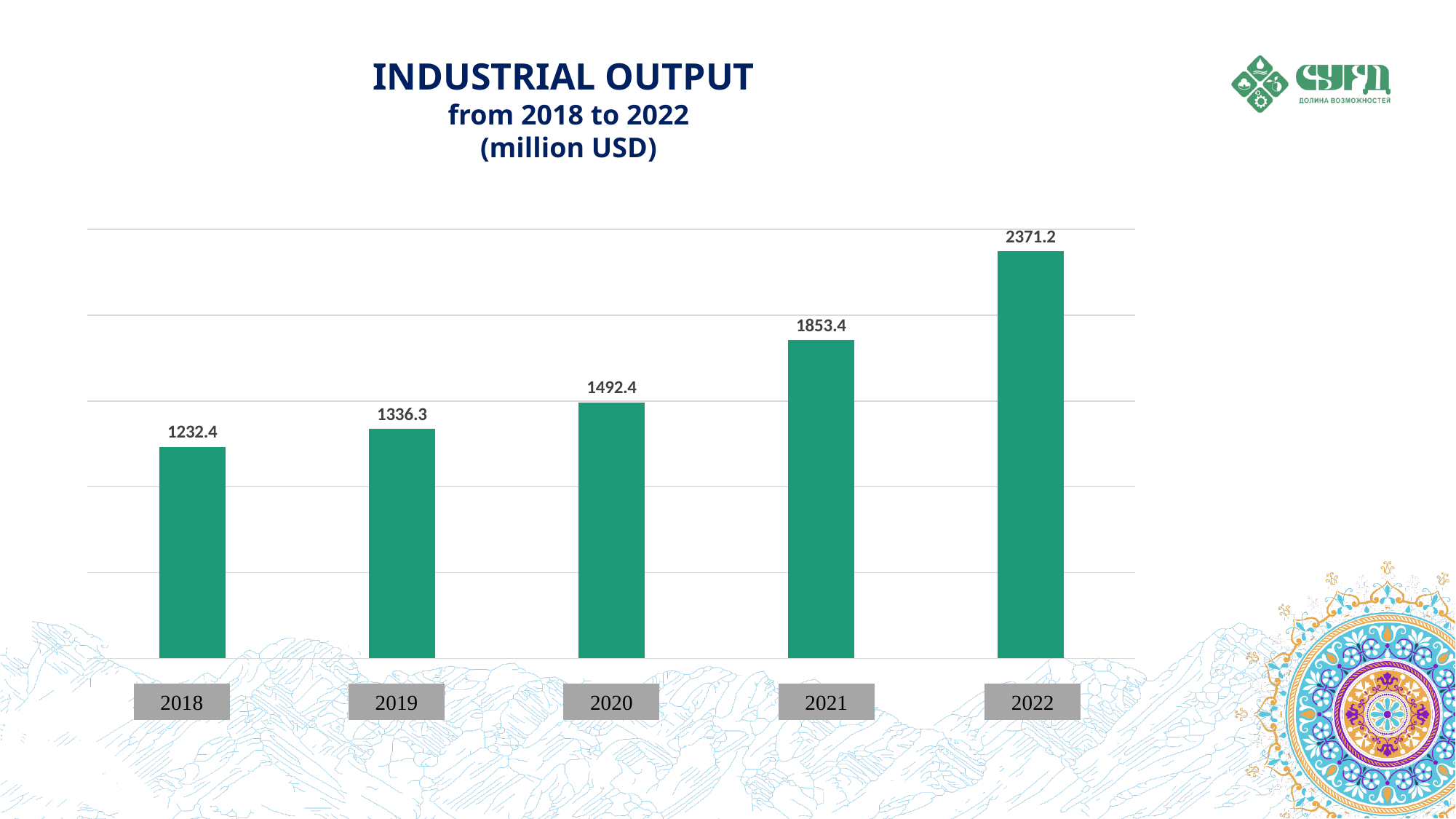
What is the difference in industrial output between 2022 and 2021? 517.8 What kind of chart is shown on the slide? Bar chart In what unit is industrial output shown in the chart? million USD How many years are shown in the chart? 5 What was the industrial output in 2020? 1492.4 Which year had the highest industrial output? 2022 What was the industrial output in 2022? 2371.2 Which year had the lowest industrial output? 2018 What was the industrial output in 2018? 1232.4 Does industrial output rise or fall from 2018 to 2022? Rise What is the difference in industrial output between 2019 and 2018? 103.9 Which year had a larger industrial output, 2020 or 2021? 2021